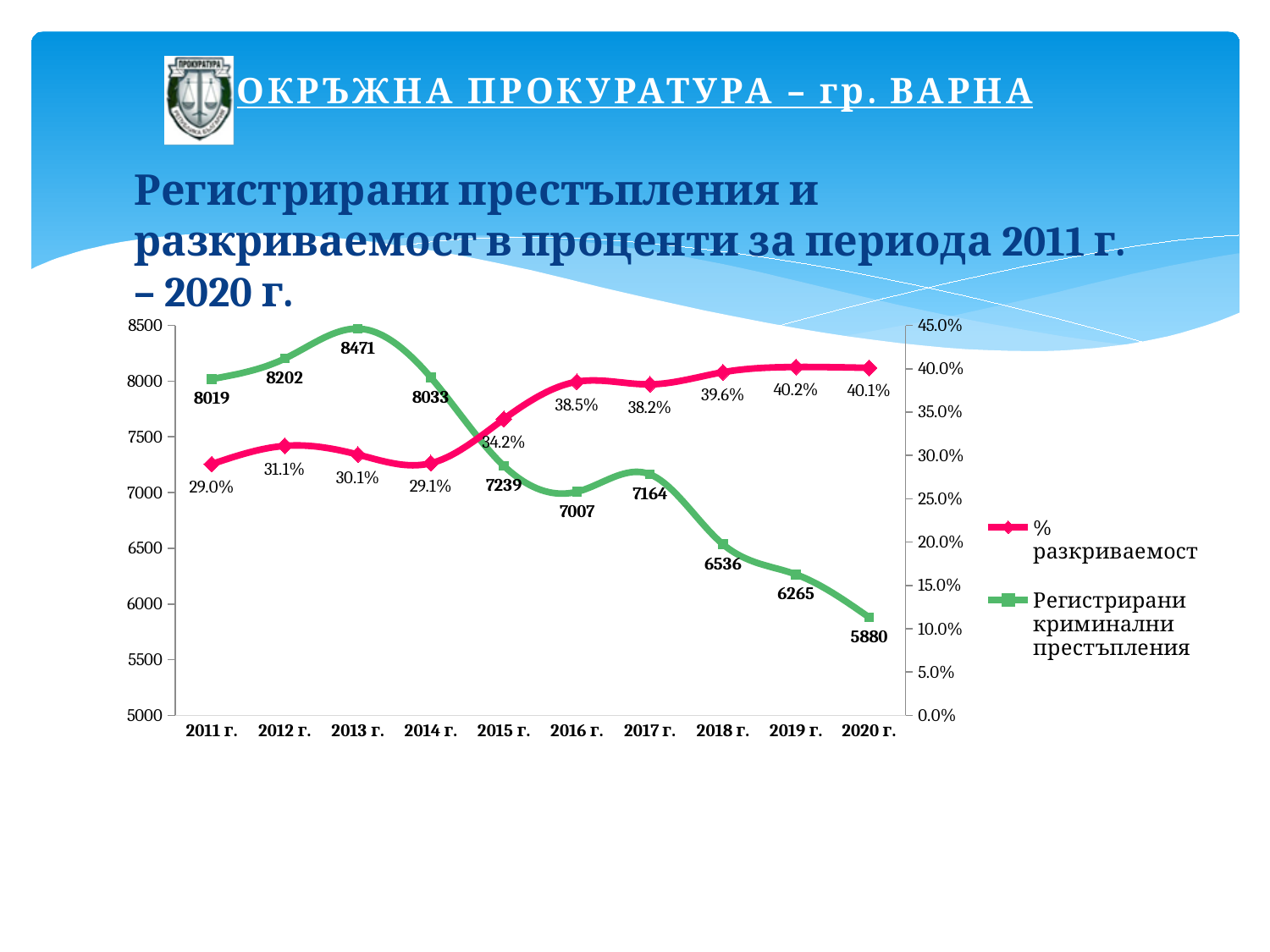
What is the % разкриваемост for 2019 г.? 40.2% Does % разкриваемост generally rise or fall from 2011 г. to 2020 г.? rise What colour is the line for % разкриваемост? pink How many years are plotted along the x axis? 10 What is the value of Регистрирани криминални престъпления for 2020 г.? 5880 What is the difference in Регистрирани криминални престъпления between 2011 г. and 2020 г.? 2139 Which is larger, Регистрирани криминални престъпления in 2017 г. or in 2018 г.? 2017 г. In which year is Регистрирани криминални престъпления highest? 2013 г. What is the value of Регистрирани криминални престъпления for 2013 г.? 8471 What kind of chart is shown on the slide? line chart How many series does the legend list? 2 In which year is % разкриваемост lowest? 2011 г.